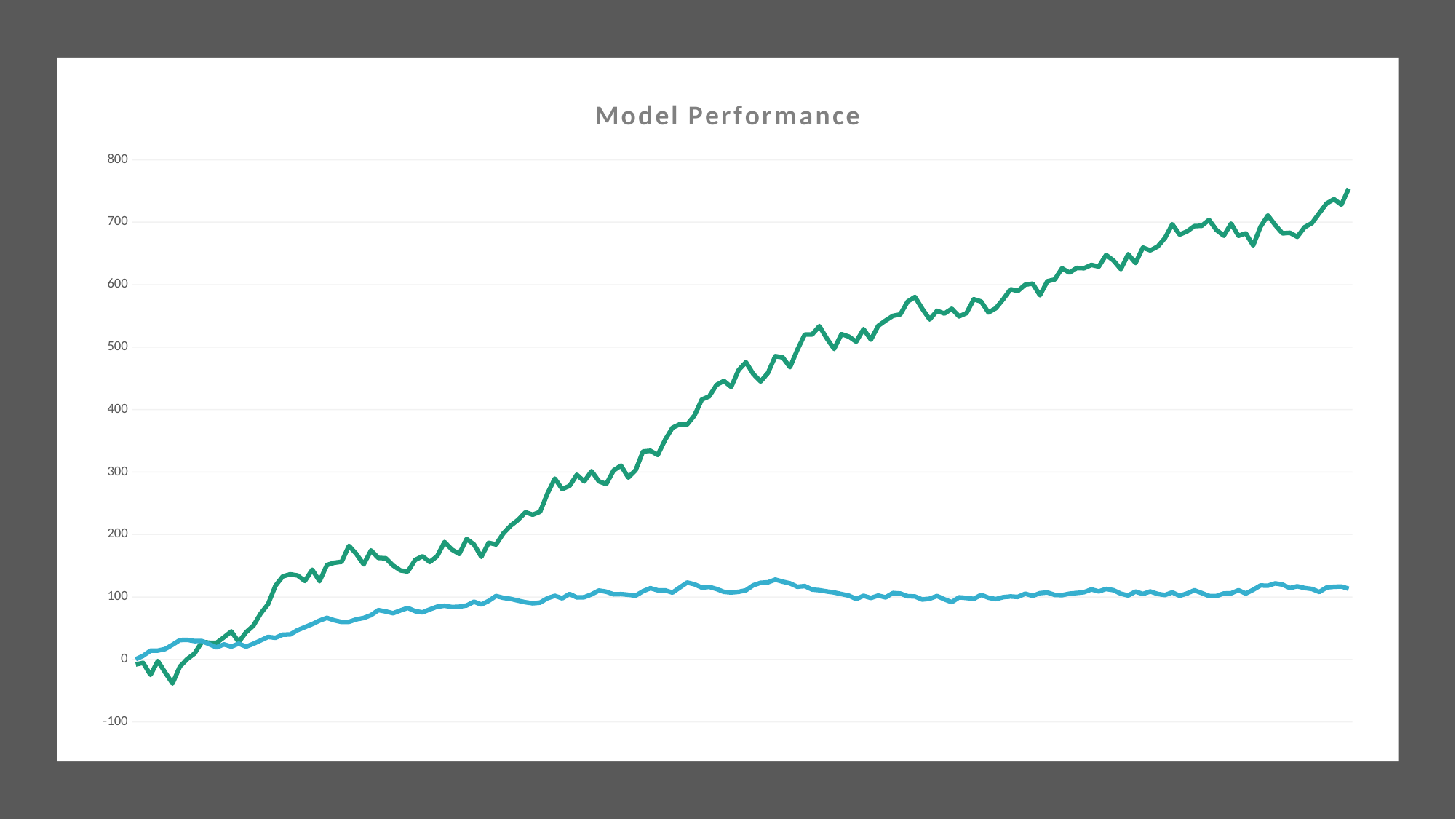
Does the green line generally rise or fall from left to right? rise Is the highest point of the green line greater or less than 800? less How many lines are plotted on the chart? 2 Which line reaches the highest value on the chart, the green line or the blue line? the green line Is the lowest point of the green line greater or less than 0? less Is the final value of the green line greater or less than 700? greater What kind of chart is shown on the slide? line chart What is the highest value shown on the vertical axis? 800 Which line ends higher at the right edge of the chart, the green line or the blue line? the green line What is the title of the chart? Model Performance